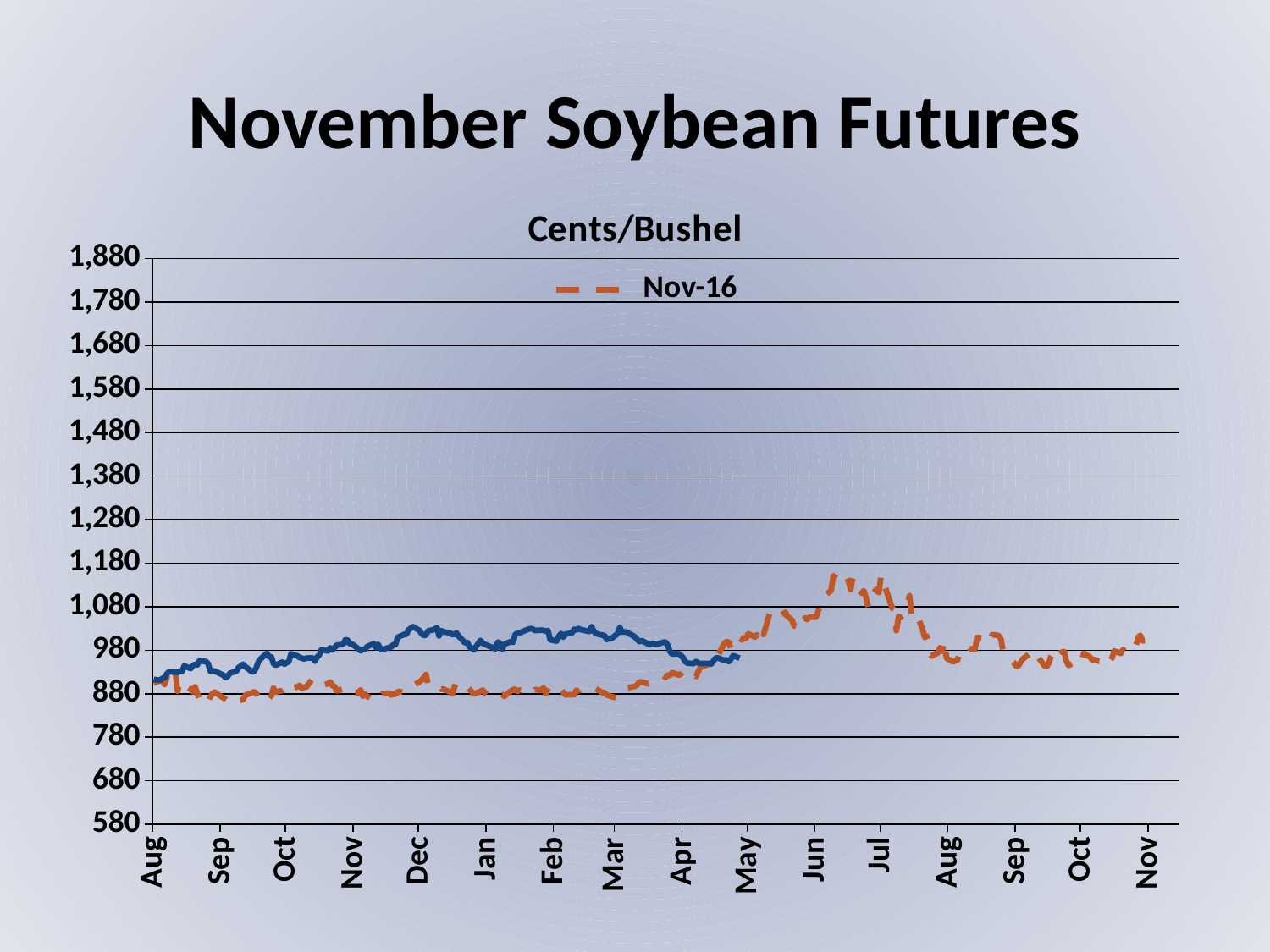
Is the value of the Nov-16 series at Oct greater or less than 1,080? less Is the value of the Nov-16 series at Jun greater or less than 980? greater Is the highest value of the Nov-16 series greater or less than 1,080? greater What is the title of the chart? Cents/Bushel Does the Nov-16 series rise or fall between Jul and Aug? fall What kind of chart is shown on the slide? line chart How many month labels are shown along the x axis? 16 How many series does the chart's legend list? 1 Does the Nov-16 series rise or fall between Apr and Jun? rise What series name appears in the chart's legend? Nov-16